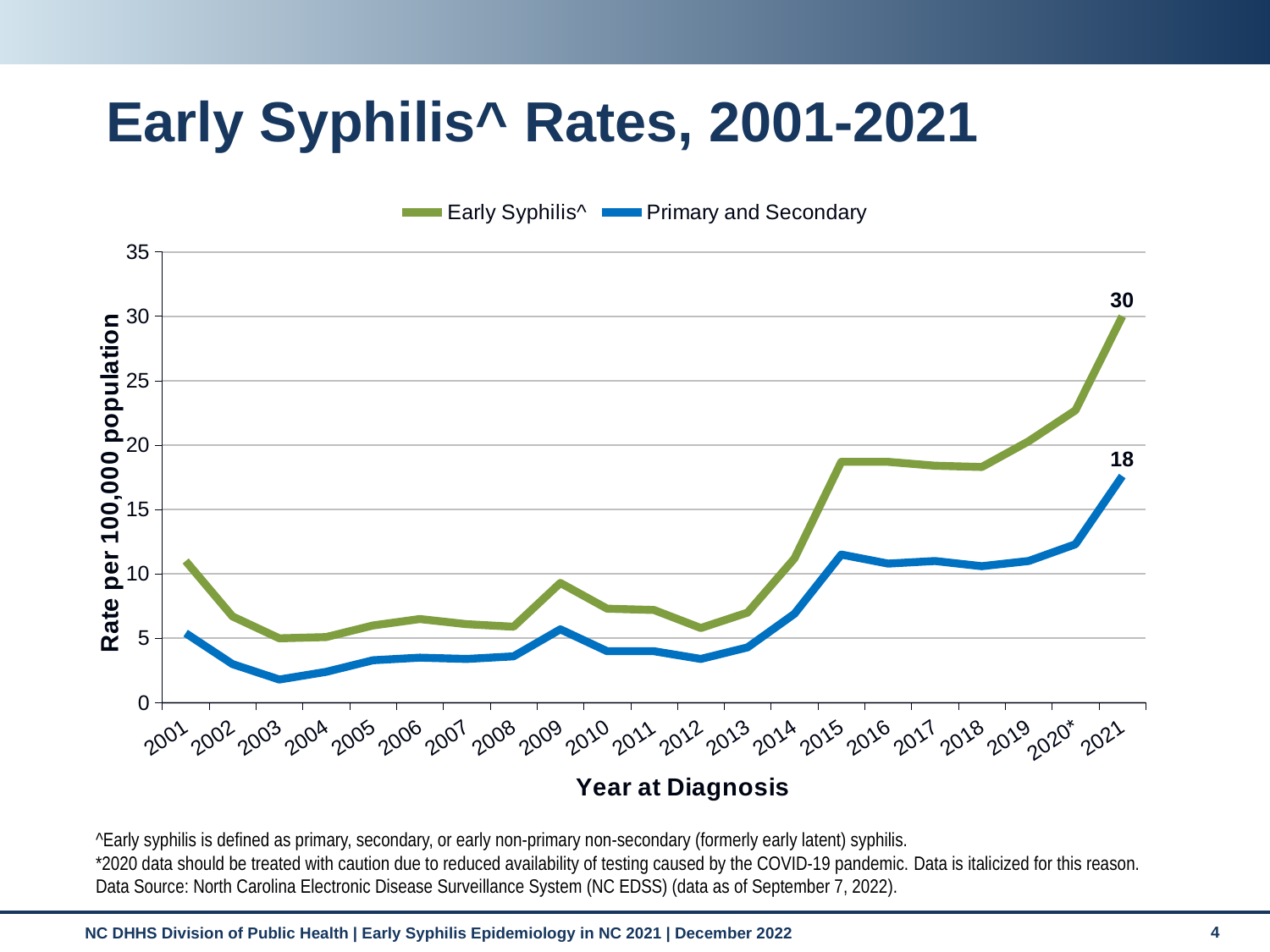
In which year is the Early Syphilis^ rate highest? 2021 Is the Early Syphilis^ rate in 2015 greater or less than 15? greater Does the Early Syphilis^ rate rise or fall from 2018 to 2021? rises How many series does the legend list? 2 In 2021, which is larger: the Early Syphilis^ rate or the Primary and Secondary rate? Early Syphilis^ Is the Primary and Secondary rate in 2003 greater or less than 5? less What is the difference between the Early Syphilis^ rate and the Primary and Secondary rate in 2021? 12 What is the Primary and Secondary rate in 2021? 18 What is the Early Syphilis^ rate in 2021? 30 What kind of chart is shown on the slide? Line chart What is the title of the y axis? Rate per 100,000 population How many years are plotted along the x axis? 21